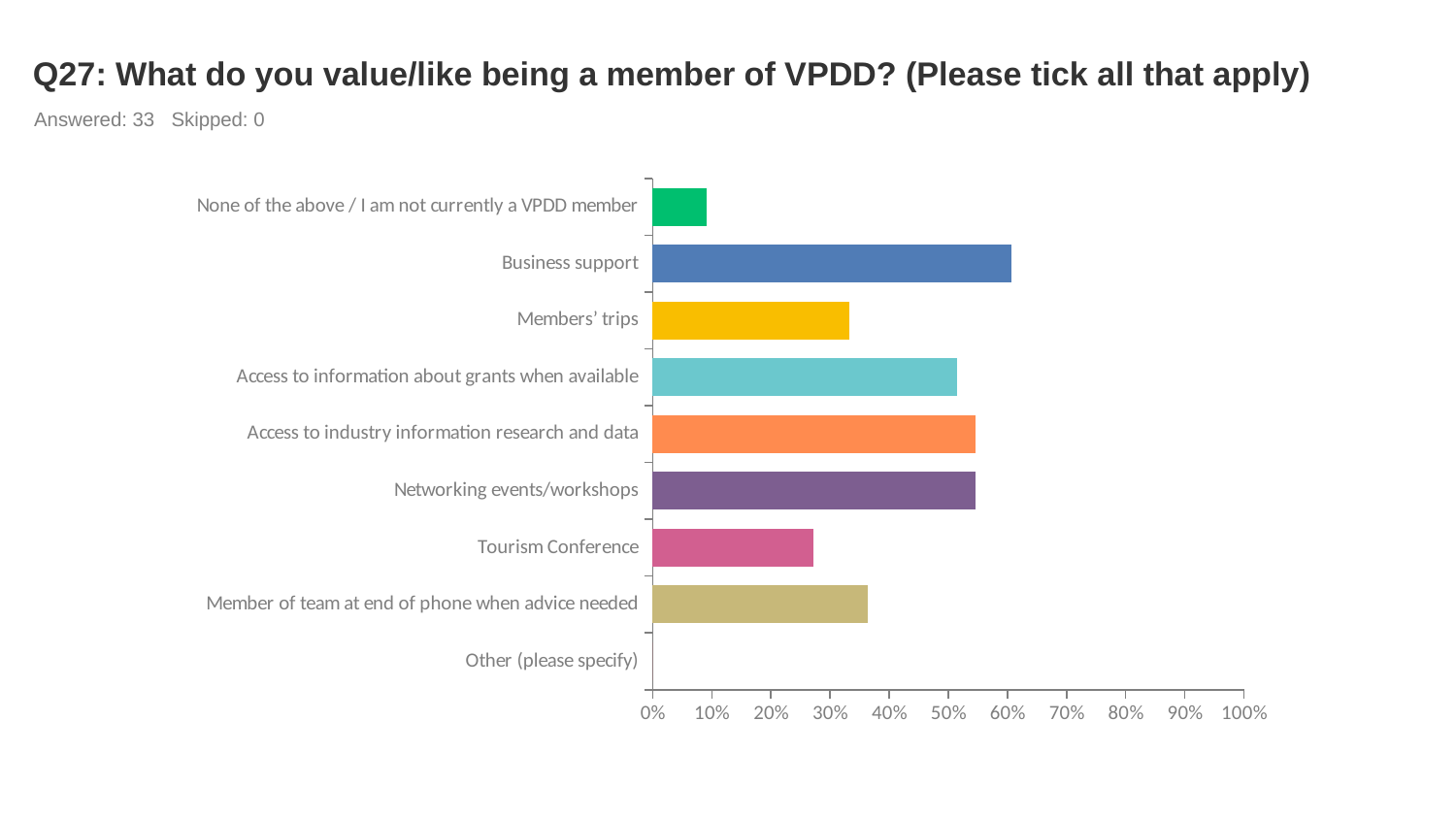
Which is larger, the value for Tourism Conference or the value for Member of team at end of phone when advice needed? Member of team at end of phone when advice needed Is the value for Networking events/workshops greater or less than 50%? greater Which category has the highest value? Business support Is the value for Tourism Conference greater or less than 20%? greater How many respondents answered the question shown in the chart title? 33 How many categories are plotted on the chart? 9 What kind of chart is shown on the slide? bar chart Which is larger, the value for Business support or the value for Members' trips? Business support Is the value for Members' trips greater or less than 40%? less Which category has the lowest value? Other (please specify)